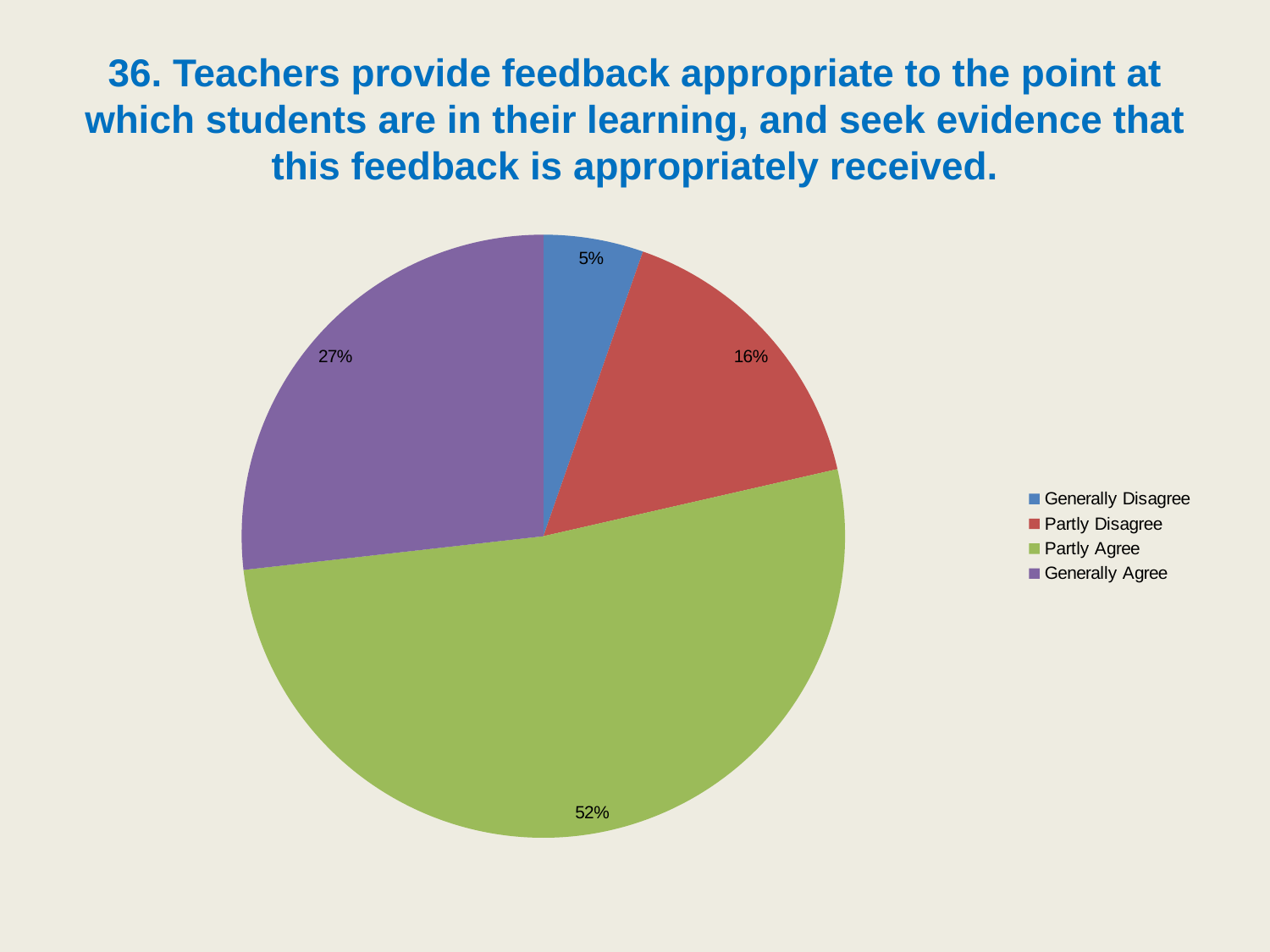
Which response category has the largest share of the pie? Partly Agree What is the difference in percentage points between Partly Agree and Generally Agree? 25 What percentage of respondents chose Partly Disagree? 16% What percentage of respondents chose Partly Agree? 52% What percentage of respondents chose Generally Agree? 27% Which is larger, the share for Partly Disagree or the share for Generally Agree? Generally Agree Which response category has the smallest share of the pie? Generally Disagree What percentage of respondents chose Generally Disagree? 5% What is the combined percentage of Generally Disagree and Partly Disagree? 21% What colour is the Partly Agree slice? Green How many categories does the legend list? 4 What kind of chart is shown on the slide? Pie chart